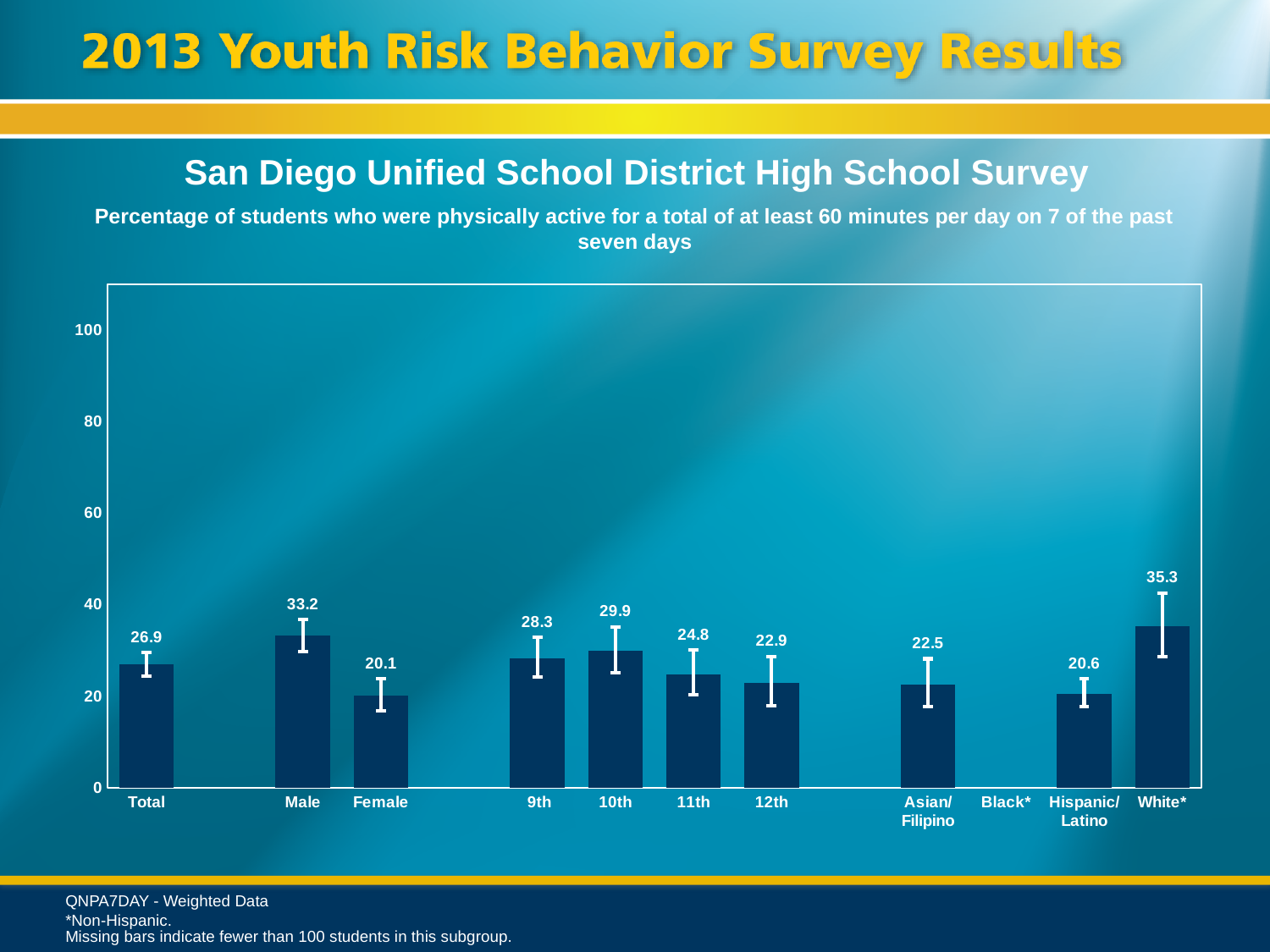
What kind of chart is shown on the slide? bar chart Which is larger, the value for 9th grade or the value for 12th grade? 9th Which category label on the x axis has no bar plotted? Black* What is the difference between the White* and Asian/Filipino values? 12.8 What is the value shown for Male students? 33.2 Which category has the lowest plotted value on the chart? Female What is the value shown for 10th grade students? 29.9 What is the difference between the Male and Female values? 13.1 Is the value for Hispanic/Latino students greater or less than 40? less How many categories have a plotted bar on the chart? 10 What percentage of students in the Total category were physically active for at least 60 minutes per day on 7 of the past seven days? 26.9 Which category has the highest value on the chart? White*